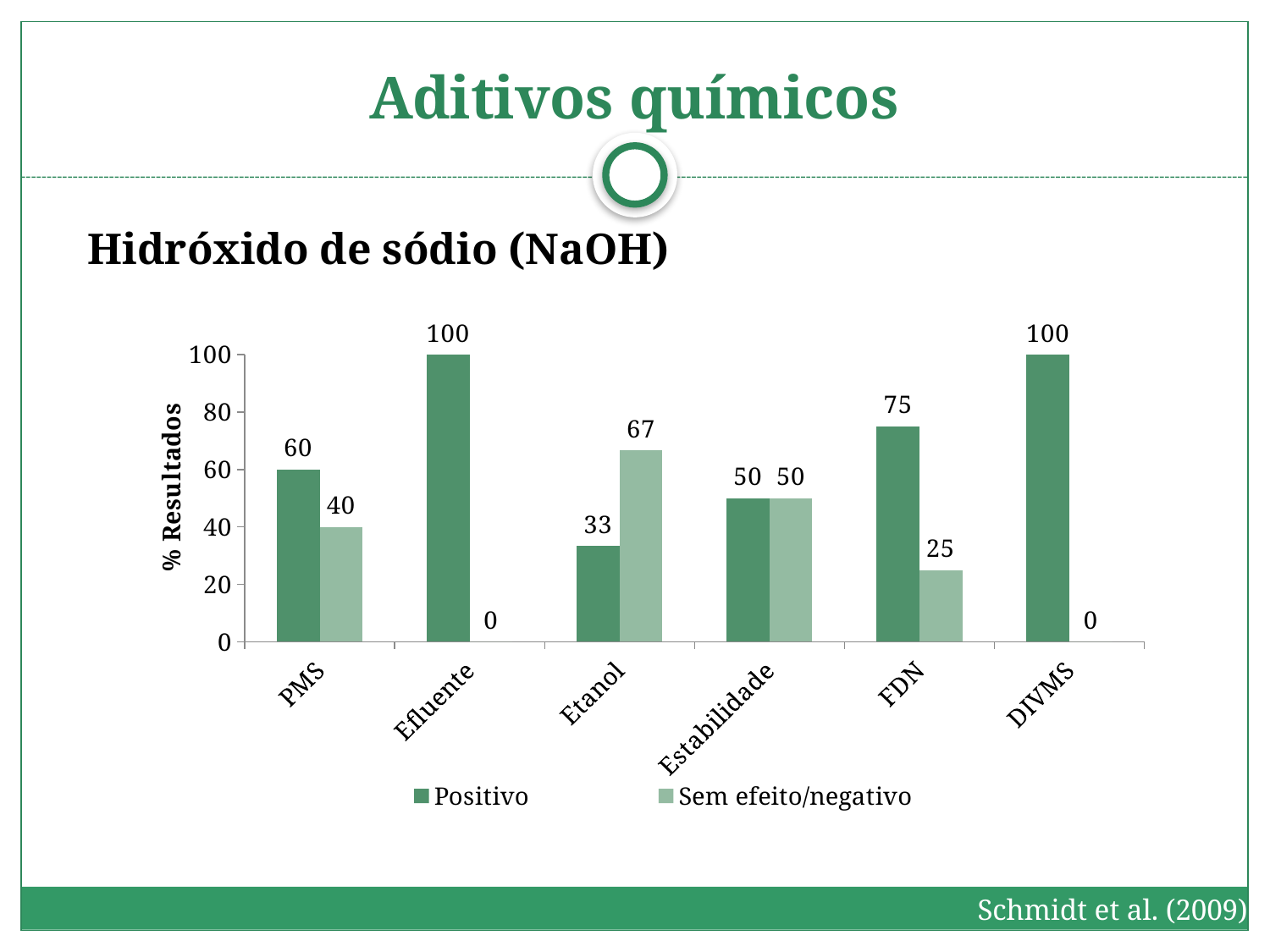
What is the difference between the Positivo and Sem efeito/negativo values for FDN? 50 What kind of chart is shown on the slide? Bar chart Which category has the lowest Positivo value? Etanol Which categories have a Positivo value of 100? Efluente and DIVMS What is the Sem efeito/negativo value for FDN? 25 Which is larger for PMS, the Positivo value or the Sem efeito/negativo value? Positivo What is the label of the y axis? % Resultados Which category has the highest Sem efeito/negativo value? Etanol What is the Positivo value for PMS? 60 How many series does the legend list? 2 How many categories are shown on the x axis? 6 What is the Sem efeito/negativo value for Etanol? 67